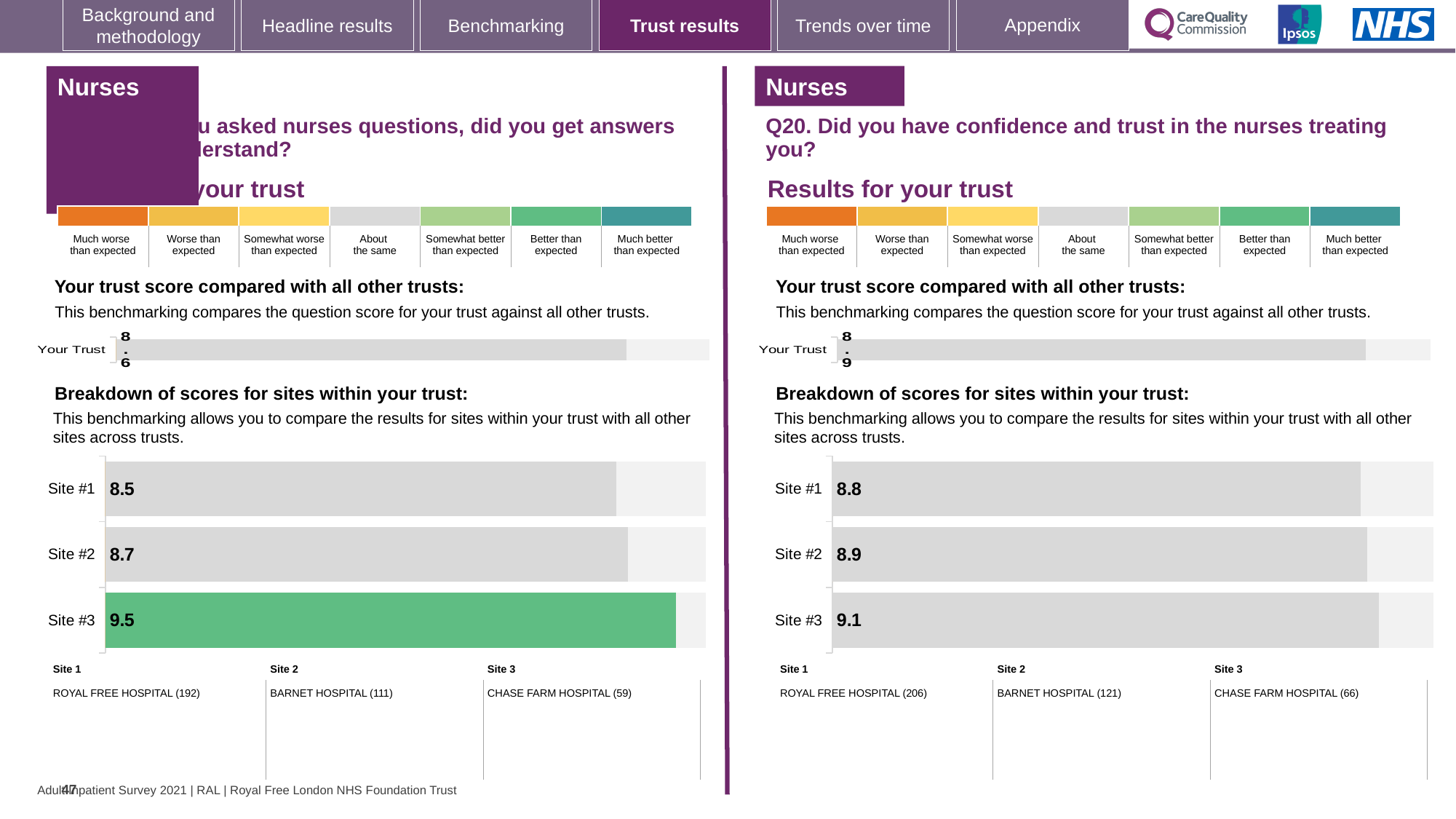
On the right-hand chart (Q20), which site has the lowest score? Site #1 On the right-hand chart (Q20), what is the difference between the scores for Site #3 and Site #2? 0.2 On the left-hand chart, what is the difference between the scores for Site #3 and Site #1? 1.0 What type of chart is used for the breakdown of scores for sites on the right-hand side (Q20)? Bar chart On the left-hand chart, which site's bar is coloured green? Site #3 On the left-hand chart, what is the score for Site #1? 8.5 On the right-hand chart (Q20), what is the 'Your Trust' score? 8.9 On the left-hand chart, what is the 'Your Trust' score? 8.6 On the right-hand chart (Q20), what is the score for Site #3? 9.1 How many sites are shown in the right-hand chart (Q20) site breakdown? 3 On the left-hand chart, which has the larger score, Site #1 or Site #2? Site #2 On the left-hand chart, which site has the highest score? Site #3